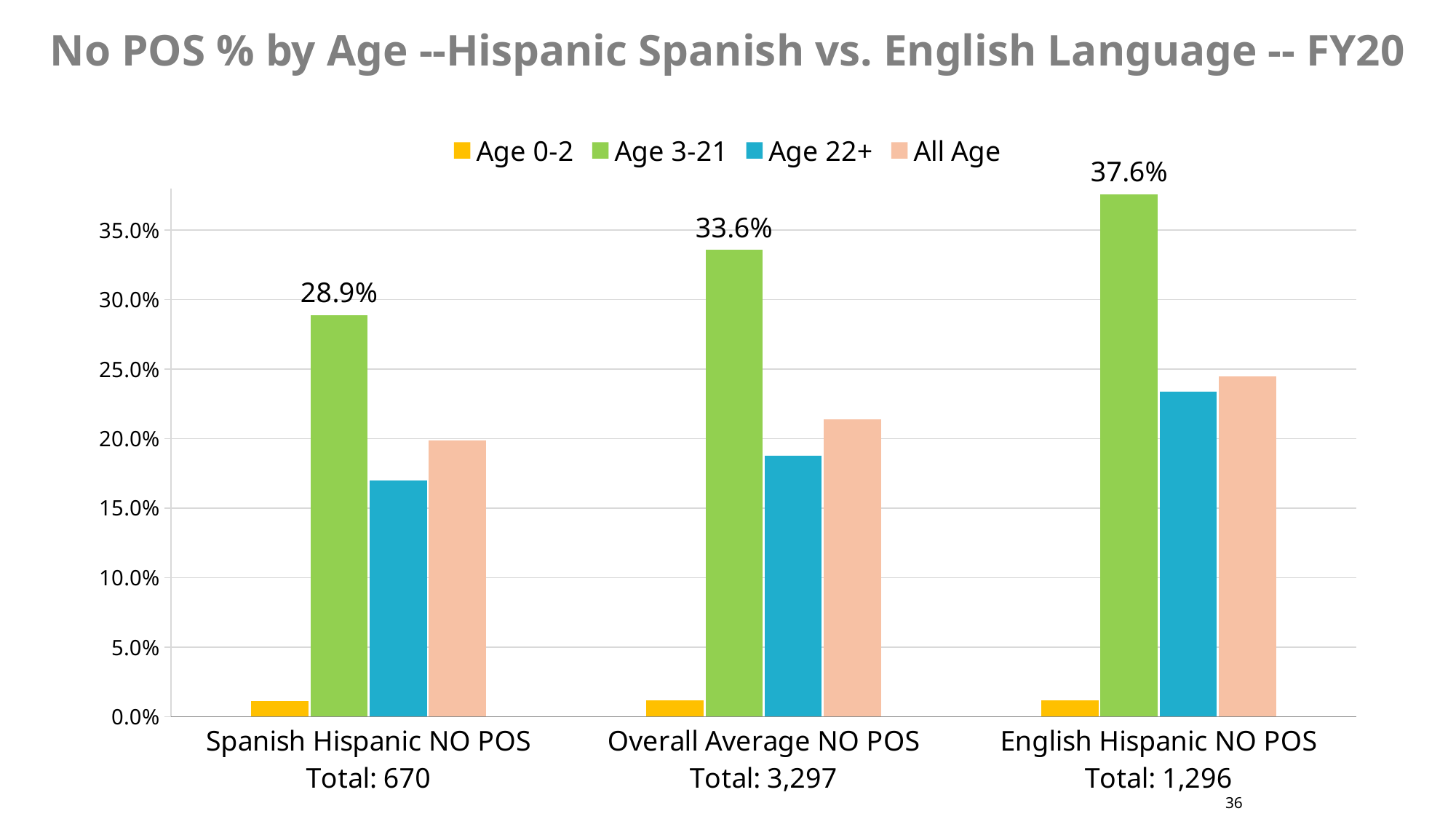
What is the value for Age 3-21 in the Overall Average NO POS group? 33.6% Which group has the highest Age 3-21 value? English Hispanic NO POS What is the value for Age 3-21 in the Spanish Hispanic NO POS group? 28.9% Is the Age 22+ value for Spanish Hispanic NO POS greater or less than 20.0%? less Is the All Age value for English Hispanic NO POS greater or less than 20.0%? greater Which group has the lowest Age 3-21 value? Spanish Hispanic NO POS Which is larger, the Age 3-21 value for Overall Average NO POS or for Spanish Hispanic NO POS? Overall Average NO POS What is the value for Age 3-21 in the English Hispanic NO POS group? 37.6% How many groups are shown on the x axis? 3 How many series does the legend list? 4 What is the difference between the Age 3-21 values for English Hispanic NO POS and Spanish Hispanic NO POS? 8.7% What kind of chart is shown on the slide? Bar chart